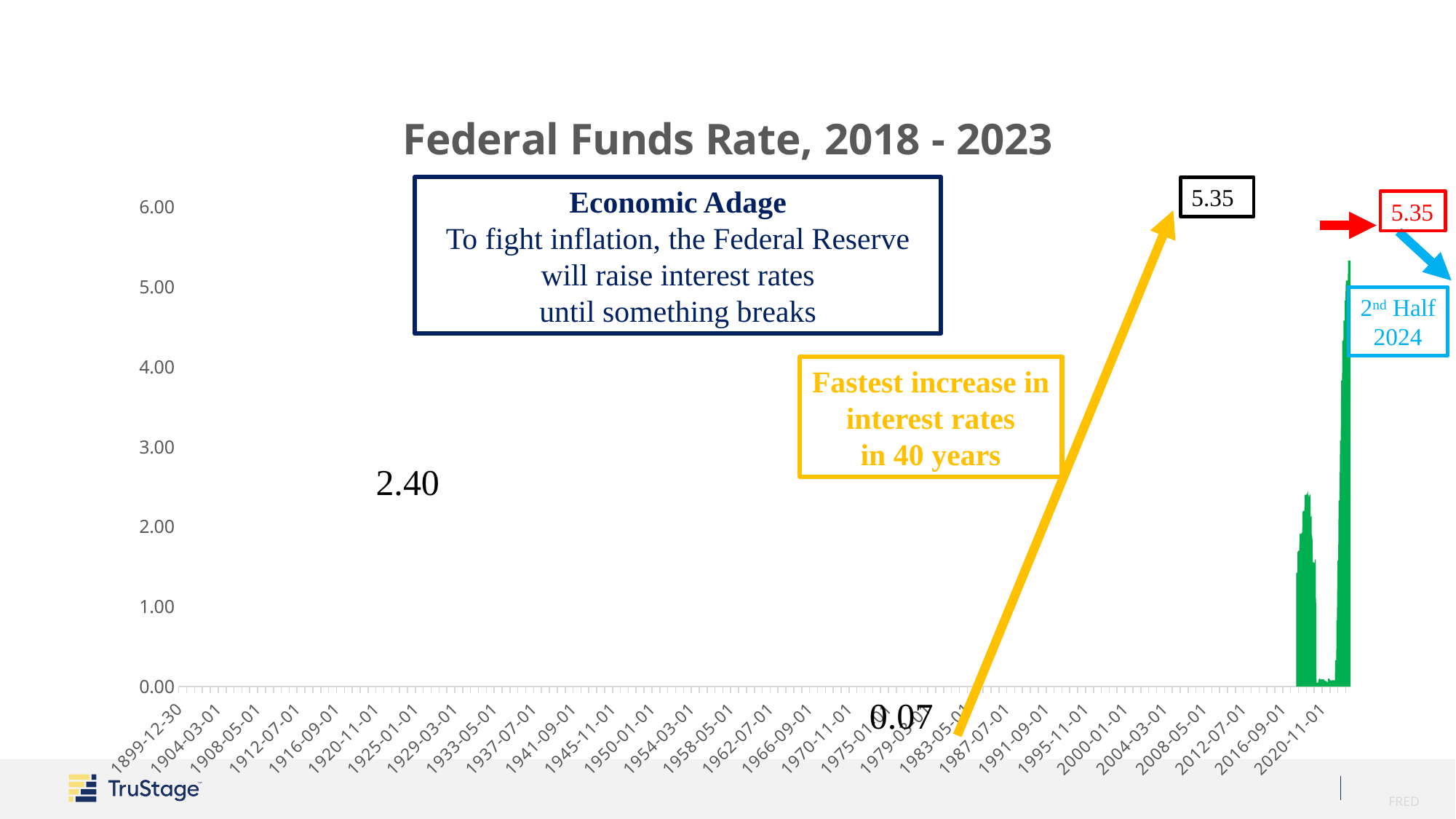
Does the Federal Funds Rate rise or fall from its 0.07 low toward the end of the plotted period? rise What is the difference between the labeled peak value 5.35 and the earlier labeled peak of 2.40? 2.95 What is the lowest value labeled on the chart for the Federal Funds Rate? 0.07 Is the earlier peak of the Federal Funds Rate (around 2019) greater or less than 3.00? less Which labeled value is larger, the 5.35 peak or the 2.40 peak? 5.35 What is the title of the chart? Federal Funds Rate, 2018 - 2023 What is the highest value labeled on the chart for the Federal Funds Rate? 5.35 What value is labeled for the earlier, smaller peak of the Federal Funds Rate on the chart? 2.40 What value does the red box give for the Federal Funds Rate in the 2nd Half of 2024? 5.35 What is the highest tick value shown on the y-axis? 6.00 Is the most recent peak of the Federal Funds Rate greater or less than 5.00? greater What is the difference between the labeled peak value 5.35 and the labeled low value 0.07? 5.28